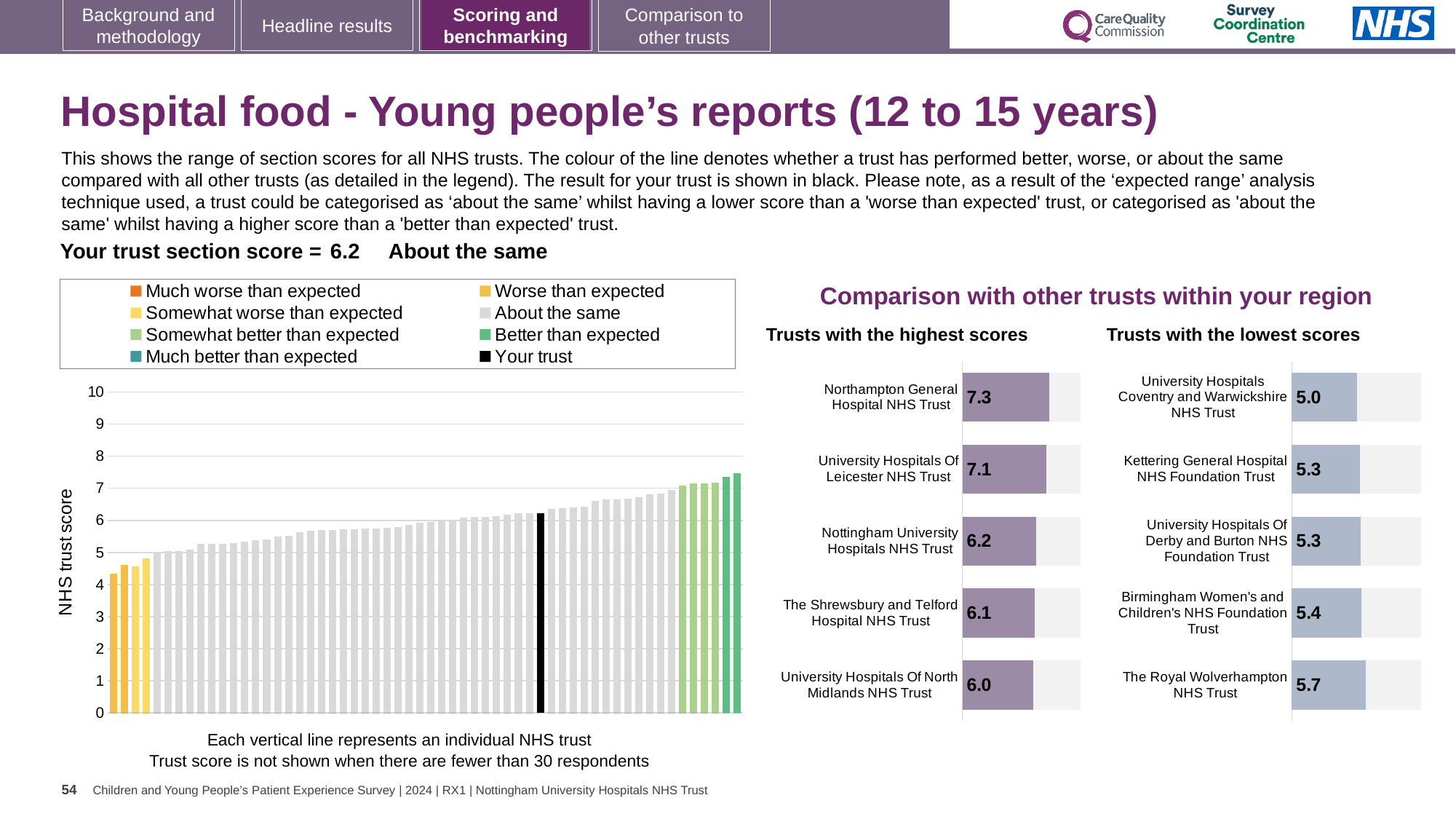
In the 'Trusts with the highest scores' chart, which has the higher score: University Hospitals Of Leicester NHS Trust or Nottingham University Hospitals NHS Trust? University Hospitals Of Leicester NHS Trust In the 'Trusts with the highest scores' chart, which trust has the highest score? Northampton General Hospital NHS Trust In the 'Trusts with the highest scores' chart, what is the score for University Hospitals Of North Midlands NHS Trust? 6.0 In the 'Trusts with the lowest scores' chart, what is the score for The Royal Wolverhampton NHS Trust? 5.7 In the large chart on the left, is the value of the lowest bar greater or less than 5? less How many trusts are shown in the 'Trusts with the lowest scores' chart? 5 In the 'Trusts with the highest scores' chart, what is the score for Northampton General Hospital NHS Trust? 7.3 In the 'Trusts with the lowest scores' chart, what is the difference between the scores of The Royal Wolverhampton NHS Trust and University Hospitals Coventry and Warwickshire NHS Trust? 0.7 In the 'Trusts with the lowest scores' chart, which trust has the lowest score? University Hospitals Coventry and Warwickshire NHS Trust In the 'Trusts with the highest scores' chart, what is the difference between the scores of Northampton General Hospital NHS Trust and University Hospitals Of North Midlands NHS Trust? 1.3 What kind of chart is the large chart on the left of the slide showing NHS trust scores? Bar chart How many entries does the legend of the large chart on the left list? 8